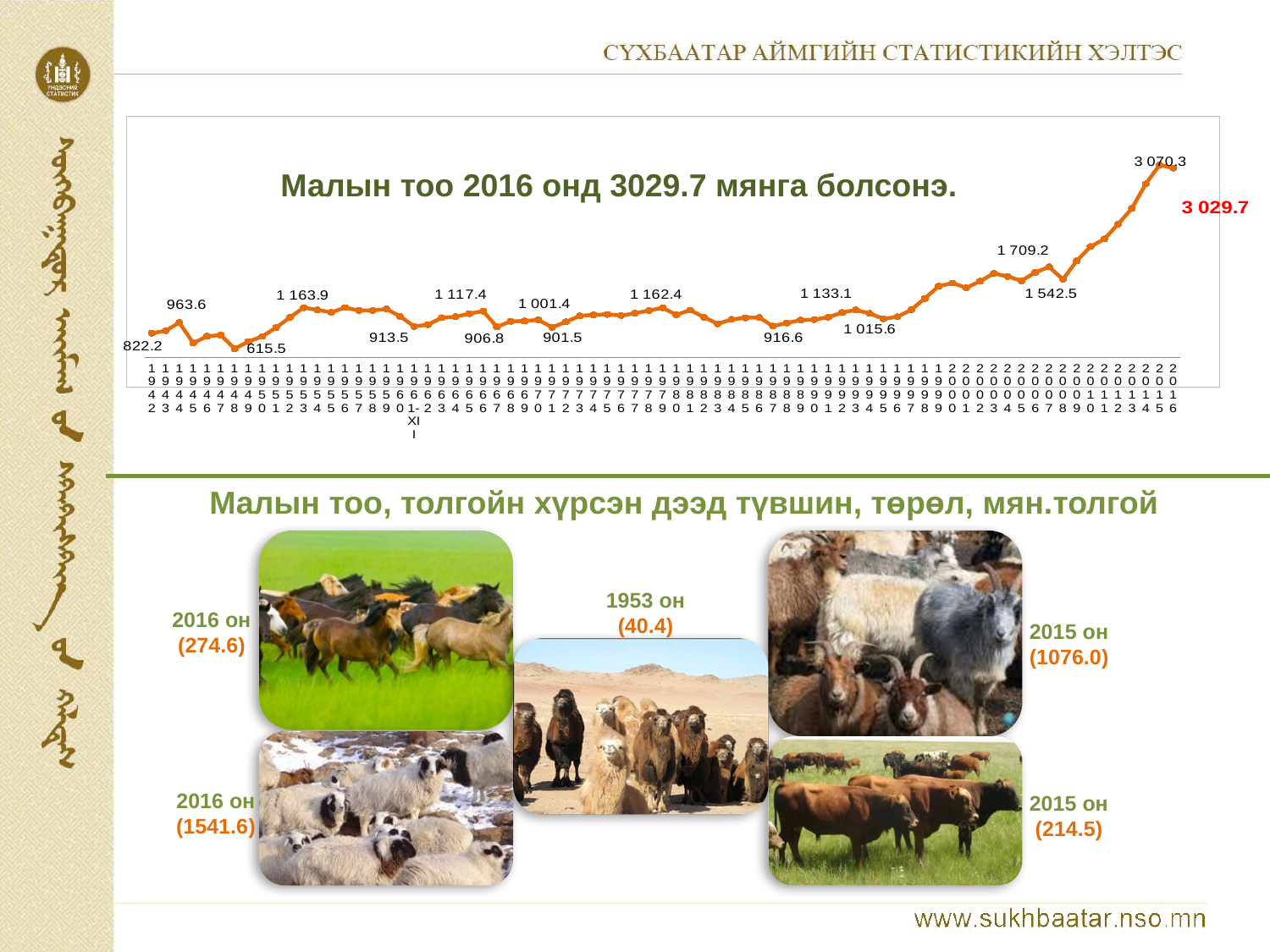
What is the highest value labeled on the line chart? 3 070.3 How many data series are plotted on the line chart? 1 What is the lowest value labeled on the line chart? 615.5 What is the difference between the labeled values 1 709.2 and 1 542.5 on the line chart? 166.7 What kind of chart is shown at the top of the slide? line chart What is the title of the line chart? Малын тоо 2016 онд 3029.7 мянга болсонэ. Does the line on the chart rise or fall over the last years leading up to 2015? rise What value is labeled in red at the end of the line chart for 2016? 3 029.7 What is the first value labeled at the left end of the line chart? 822.2 What colour is the line on the chart? orange What is the difference between the labeled values 3 070.3 and 3 029.7 on the line chart? 40.6 Which labeled value is larger on the line chart: 1 163.9 or 1 117.4? 1 163.9